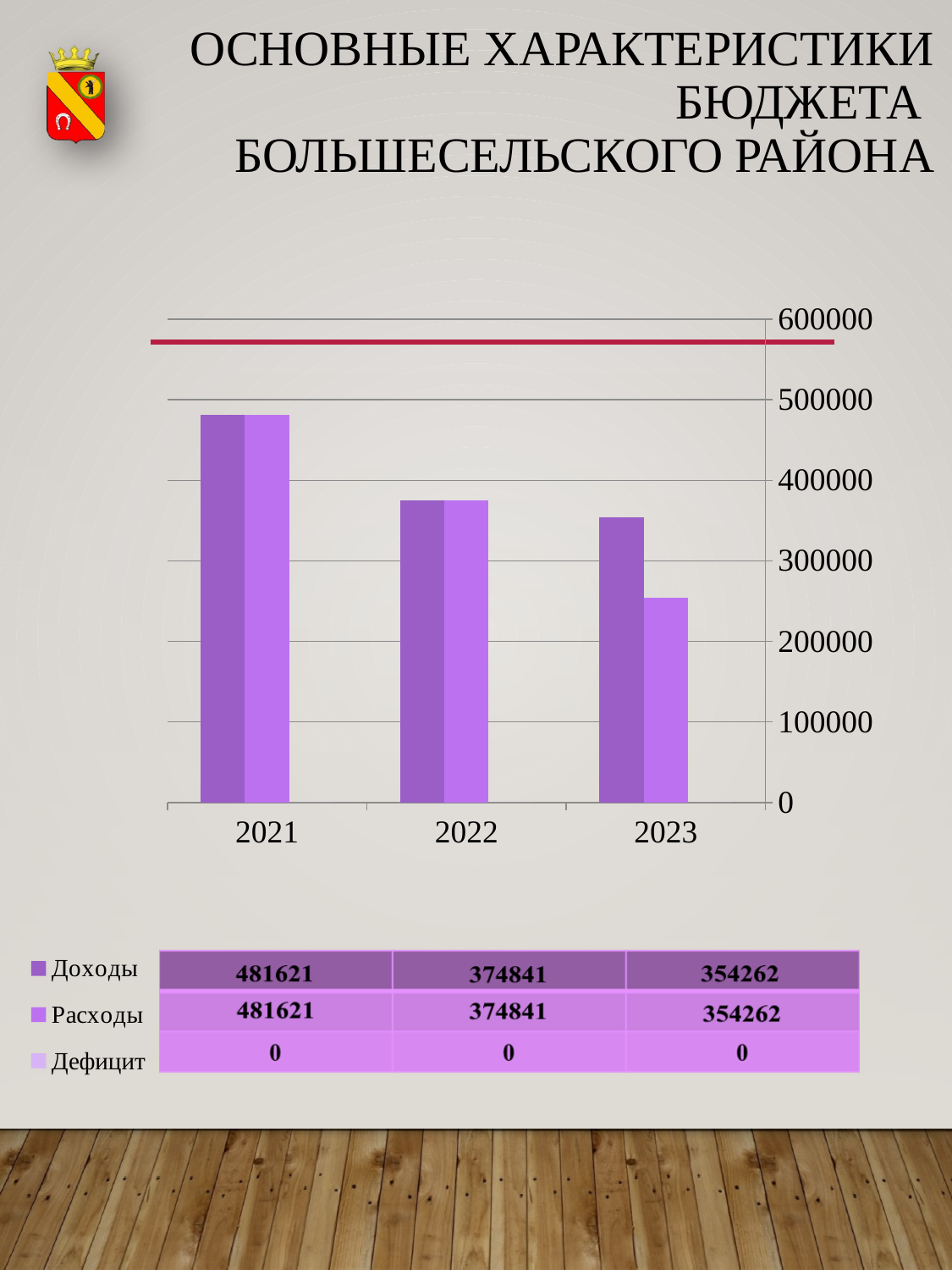
Is the value of Доходы for 2021 greater or less than 400000? greater Do the Доходы values rise or fall from 2021 to 2023? fall How many series does the legend list? 3 What is the value of Доходы for 2021? 481621 In which year is Доходы highest? 2021 What is the value of Дефицит for 2022? 0 What is the value of Доходы for 2023? 354262 What is the difference between Доходы in 2021 and Доходы in 2022? 106780 In which year is Доходы lowest? 2023 What kind of chart is shown on the slide? bar chart What is the value of Доходы for 2022? 374841 How many years are shown on the x axis? 3